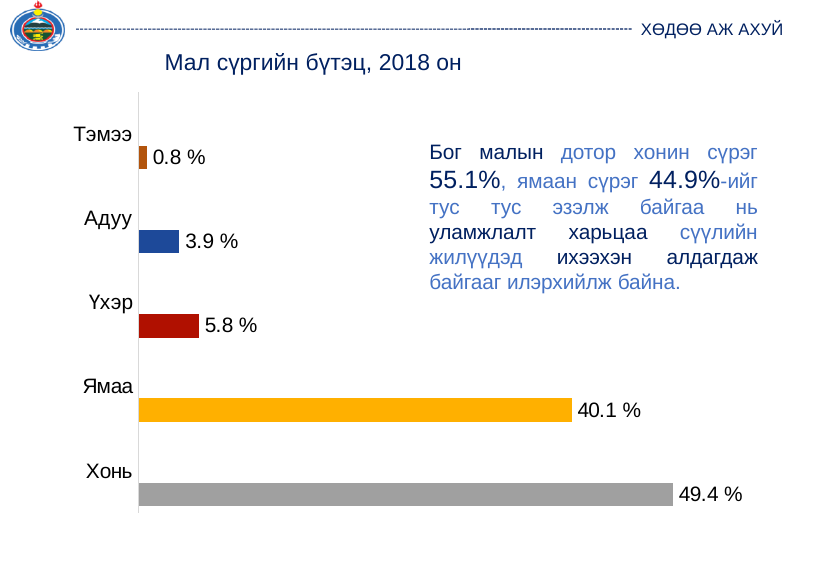
What kind of chart is shown on the slide? Bar chart What is the title of the chart? Мал сүргийн бүтэц, 2018 он Which category has the lowest value? Тэмээ What is the value for Тэмээ? 0.8 % Which is larger, the value for Үхэр or the value for Адуу? Үхэр What is the value for Ямаа? 40.1 % What is the difference between the values for Хонь and Ямаа? 9.3 % What is the value for Үхэр? 5.8 % What is the value for Хонь? 49.4 % Which category has the highest value? Хонь How many categories are shown in the chart? 5 What is the value for Адуу? 3.9 %